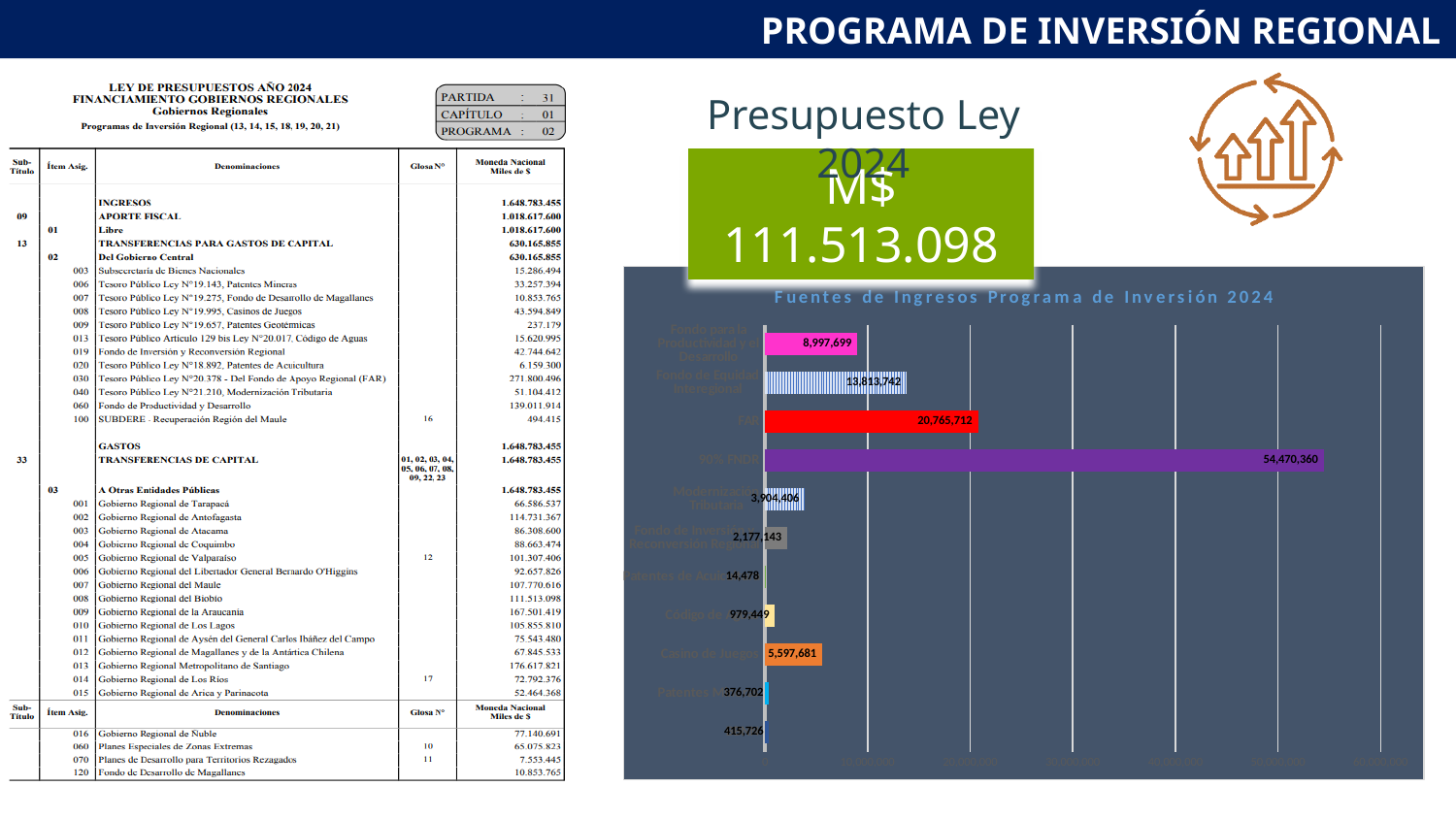
In the 'Fuentes de Ingresos Programa de Inversión 2024' chart, which is larger: Casino de Juegos or Código de Aguas? Casino de Juegos In the 'Fuentes de Ingresos Programa de Inversión 2024' chart, which category has the highest value? 90% FNDR In the 'Fuentes de Ingresos Programa de Inversión 2024' chart, what is the value for 90% FNDR? 54,470,360 How many bars are plotted in the 'Fuentes de Ingresos Programa de Inversión 2024' chart? 11 In the 'Fuentes de Ingresos Programa de Inversión 2024' chart, what is the value for Código de Aguas? 979,449 In the 'Fuentes de Ingresos Programa de Inversión 2024' chart, what is the difference between the 90% FNDR value and the FAR value? 33,704,648 In the 'Fuentes de Ingresos Programa de Inversión 2024' chart, what is the value for FAR? 20,765,712 What is the title of the bar chart on the slide? Fuentes de Ingresos Programa de Inversión 2024 In the 'Fuentes de Ingresos Programa de Inversión 2024' chart, what is the value for Casino de Juegos? 5,597,681 What type of chart is shown under the title 'Fuentes de Ingresos Programa de Inversión 2024'? bar chart In the 'Fuentes de Ingresos Programa de Inversión 2024' chart, what is the value for Fondo de Equidad Interregional? 13,813,742 In the 'Fuentes de Ingresos Programa de Inversión 2024' chart, which is larger: FAR or Fondo de Equidad Interregional? FAR